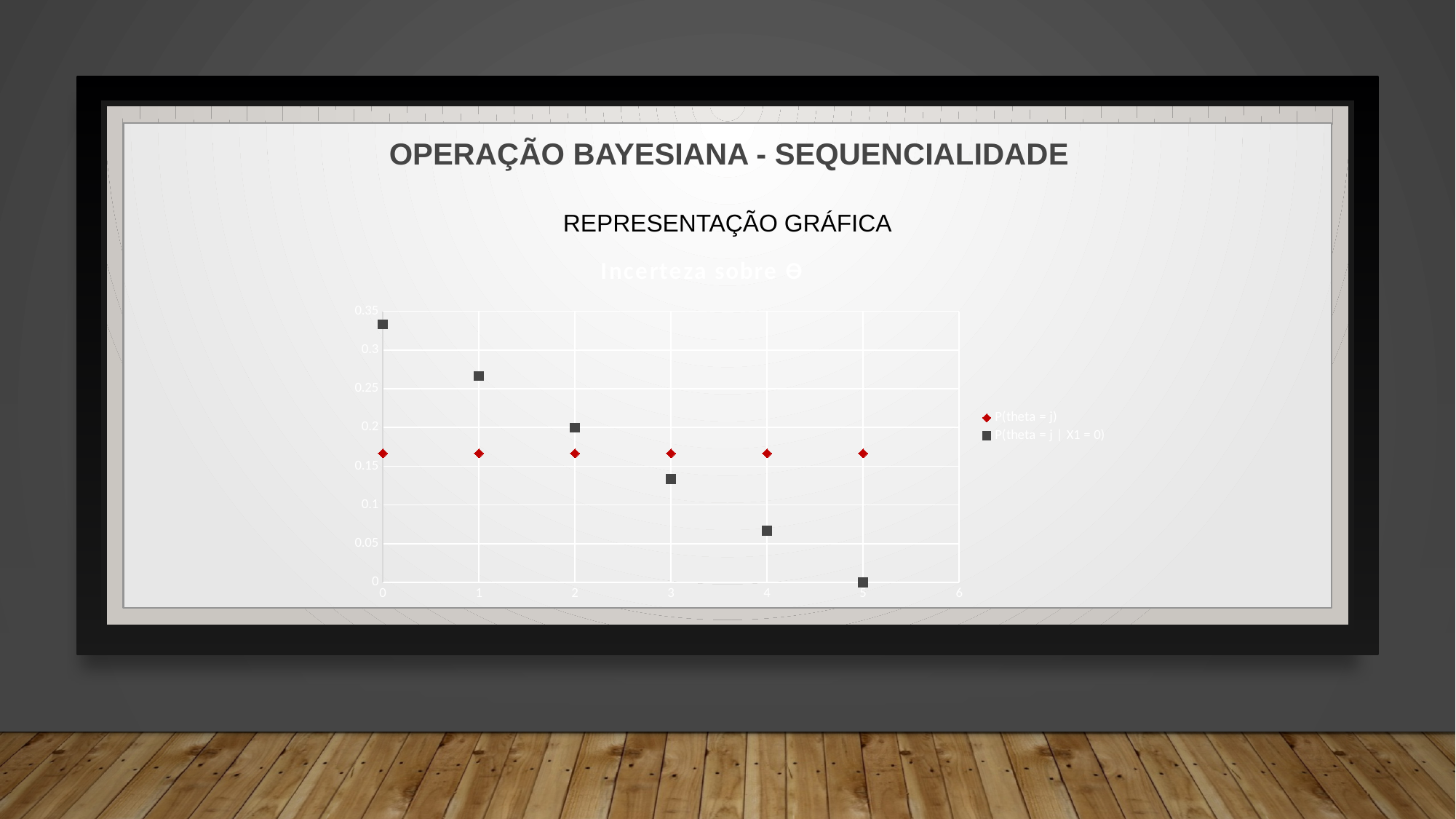
At x = 1, which series has the larger value, P(theta = j) or P(theta = j | X1 = 0)? P(theta = j | X1 = 0) How many points are plotted for the P(theta = j | X1 = 0) series? 6 At x = 4, which series has the larger value, P(theta = j) or P(theta = j | X1 = 0)? P(theta = j) What is the value of P(theta = j | X1 = 0) at x = 5? 0 How many series does the chart legend list? 2 At which x value is the P(theta = j | X1 = 0) series highest? 0 Is the value of P(theta = j | X1 = 0) at x = 4 greater or less than 0.1? less Do the values of the P(theta = j | X1 = 0) series rise or fall as x increases? fall Is the value of P(theta = j | X1 = 0) at x = 0 greater or less than 0.3? greater What kind of chart is shown on the slide? scatter chart What is the title of the chart? Incerteza sobre Θ Is the value of P(theta = j) at x = 2 greater or less than 0.2? less